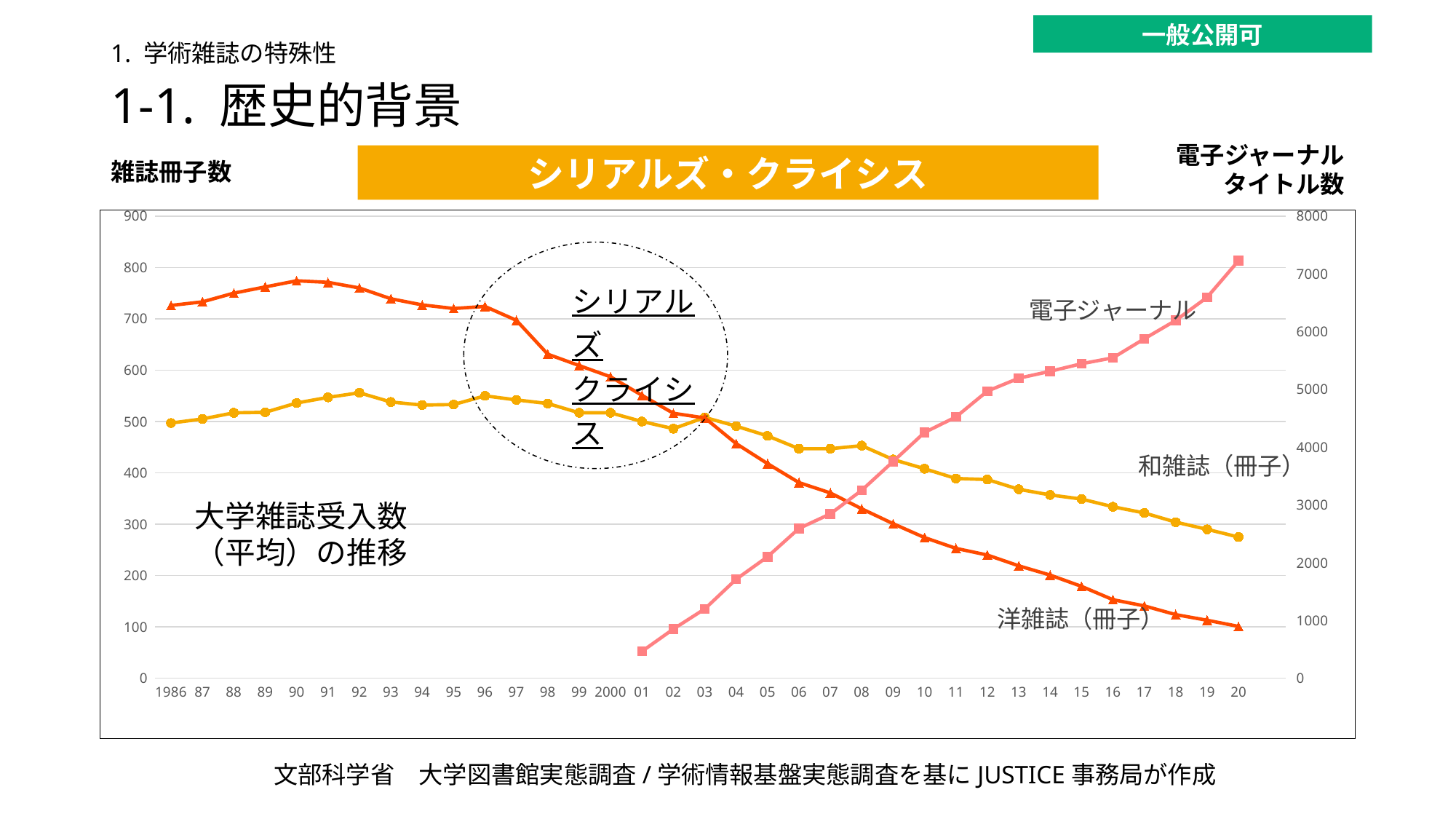
Is the value for 和雑誌（冊子） in 20 greater or less than 300? less In 1986, which series has the larger value, 洋雑誌（冊子） or 和雑誌（冊子）? 洋雑誌（冊子） Is the value for 電子ジャーナル in 01 greater or less than 1000? less What is the title printed inside the chart area? 大学雑誌受入数（平均）の推移 Does the value for 電子ジャーナル rise or fall from 01 to 20? rise In which year is the value for 電子ジャーナル highest? 20 Is the value for 洋雑誌（冊子） in 1986 greater or less than 700? greater How many data series are plotted in the chart? 3 In which year is the value for 洋雑誌（冊子） lowest? 20 What kind of chart is shown on the slide? line chart How many years are shown on the x axis of the chart? 35 Does the value for 和雑誌（冊子） rise or fall from 08 to 20? fall